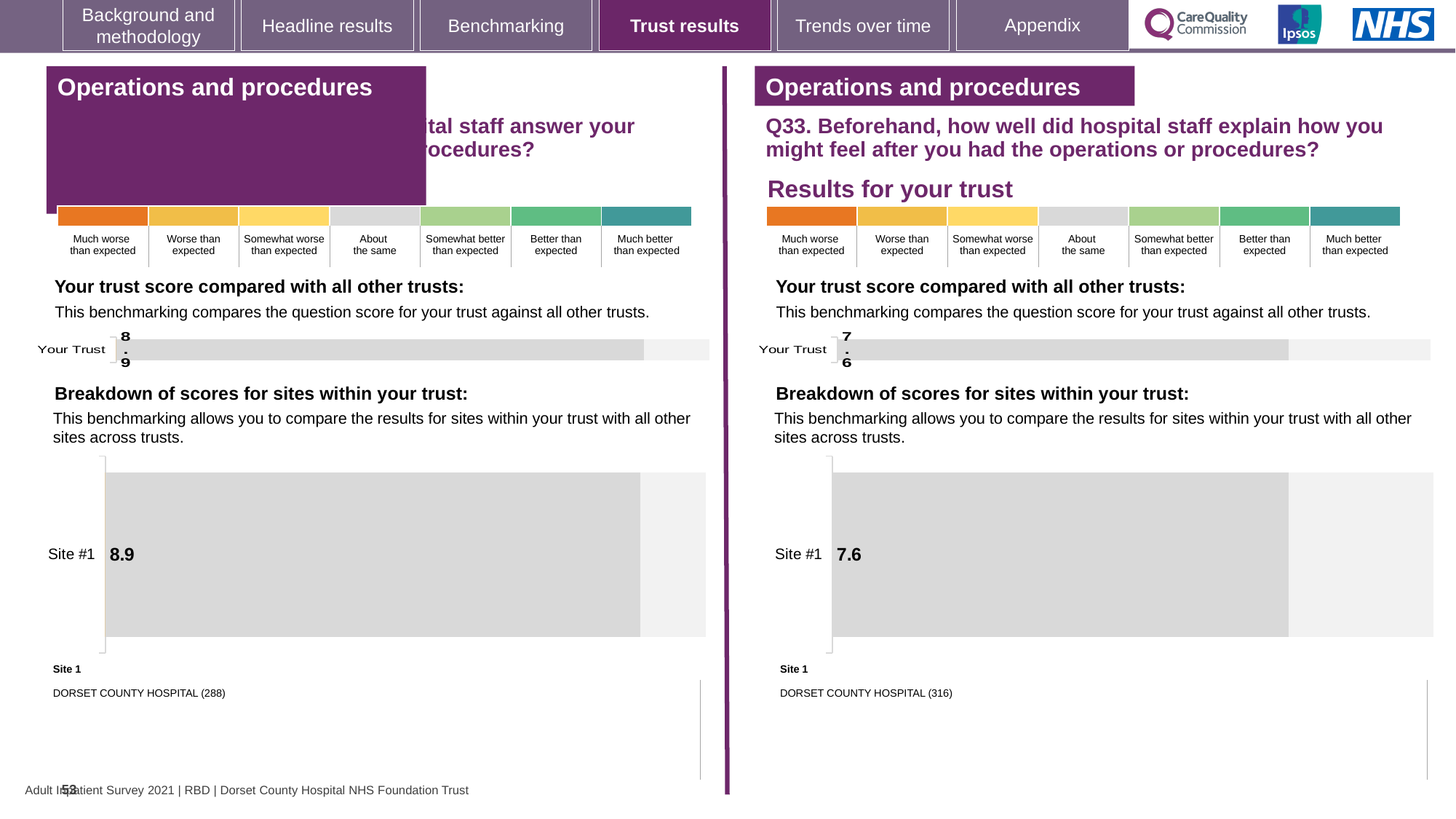
On the right chart (Q33), what is the score shown for Your Trust? 7.6 On the left chart, what is the score shown for Site #1? 8.9 What is the difference between the Site #1 score on the left chart and the Site #1 score on the right chart (Q33)? 1.3 On the right chart (Q33), what is the score shown for Site #1? 7.6 On the right panel (Q33), how many categories does the colour scale above the chart list, from 'Much worse than expected' to 'Much better than expected'? 7 Which is larger, the Your Trust score on the left chart or the Your Trust score on the right chart (Q33)? left chart What kind of chart is used to show the Site #1 score on the right panel (Q33)? bar chart On the left panel, what number appears in parentheses after DORSET COUNTY HOSPITAL for Site 1? 288 On the left chart, what is the score shown for Your Trust? 8.9 On the right chart (Q33), how many sites are shown in the breakdown of scores for sites within your trust? 1